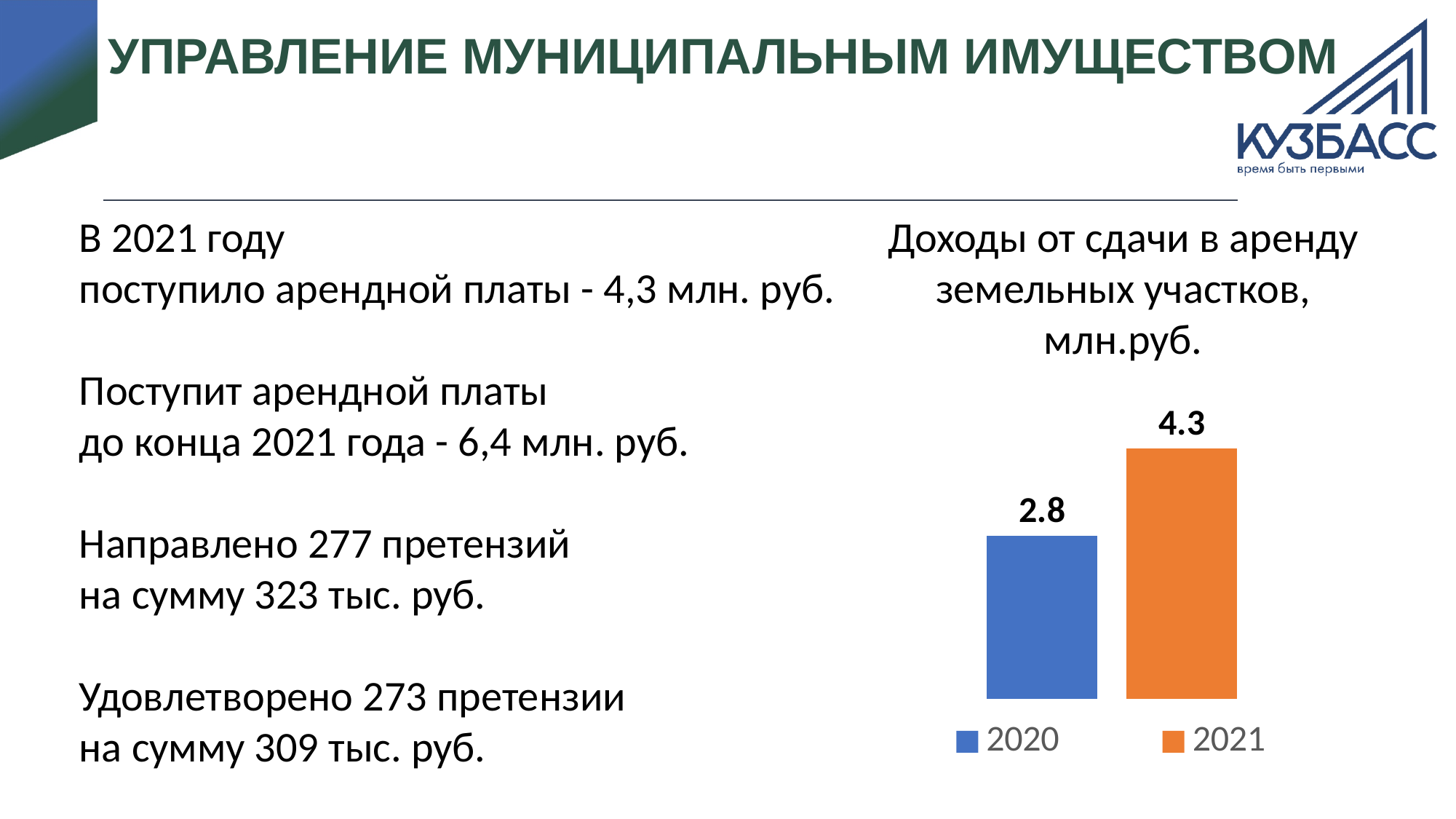
How many entries does the chart legend list? 2 What type of chart is shown on the slide? bar chart How many bars are shown in the chart? 2 Which year has the lower value in the chart? 2020 What is the title of the chart? Доходы от сдачи в аренду земельных участков, млн.руб. Do the values rise or fall from 2020 to 2021? rise What colour is the bar for 2021? orange What is the difference between the 2021 and 2020 values in the chart? 1.5 Which year has the higher value in the chart? 2021 What is the value for 2021 in the chart? 4.3 Is the value for 2021 larger or smaller than the value for 2020? larger What is the value for 2020 in the chart? 2.8